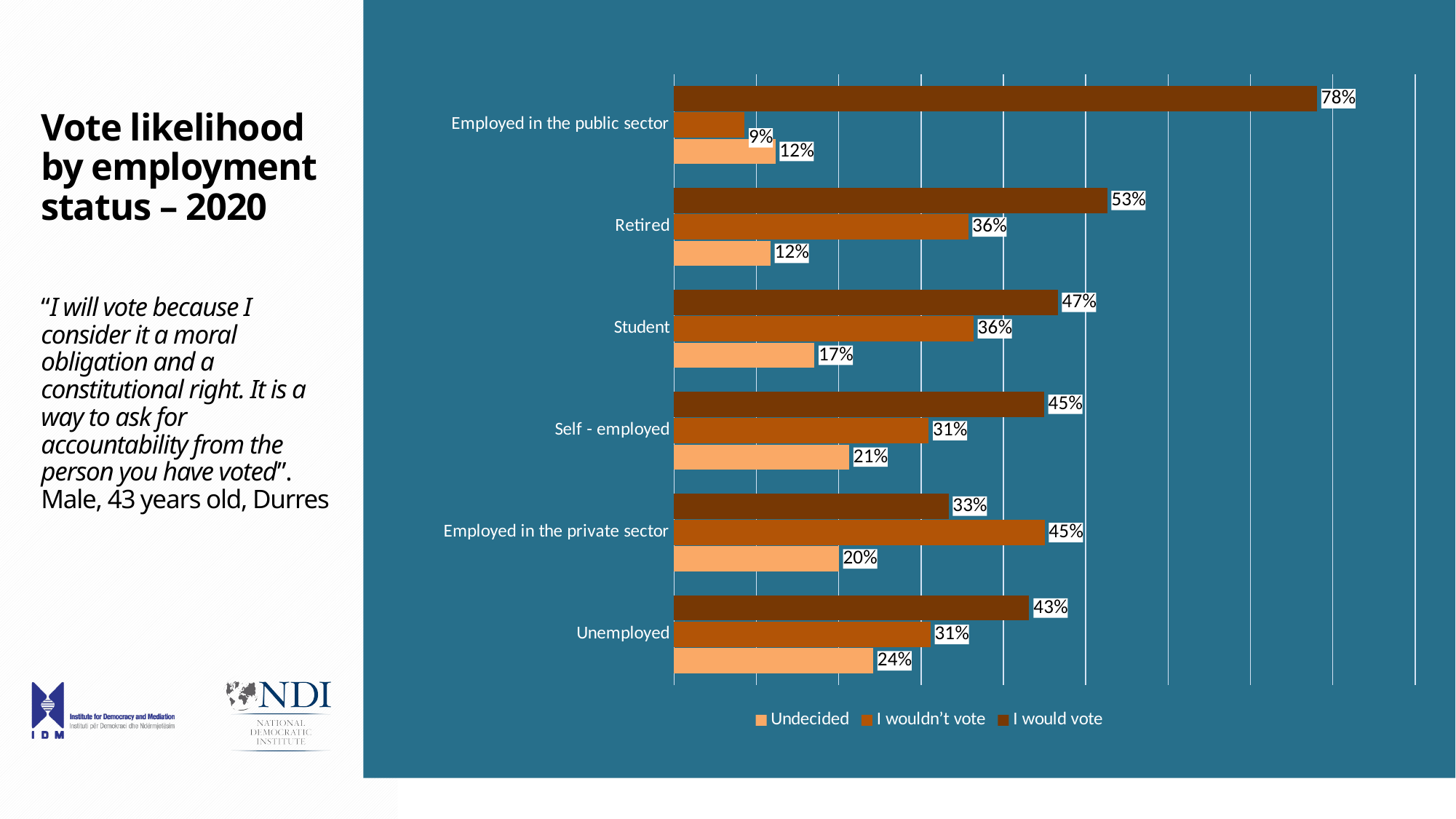
What is the "I wouldn't vote" value for Retired? 36% What is the "I would vote" value for Employed in the private sector? 33% What kind of chart is shown on the slide? Bar chart What is the Undecided value for Unemployed? 24% How many series does the legend list? 3 What percentage of those employed in the public sector said "I would vote"? 78% How many employment categories are shown in the chart? 6 What is the difference between the "I would vote" values for Retired and Student? 6% What is the title of the chart on the slide? Vote likelihood by employment status – 2020 For Employed in the private sector, which is larger: "I would vote" or "I wouldn't vote"? I wouldn't vote Which employment category has the highest "I would vote" value? Employed in the public sector Which employment category has the lowest "I wouldn't vote" value? Employed in the public sector